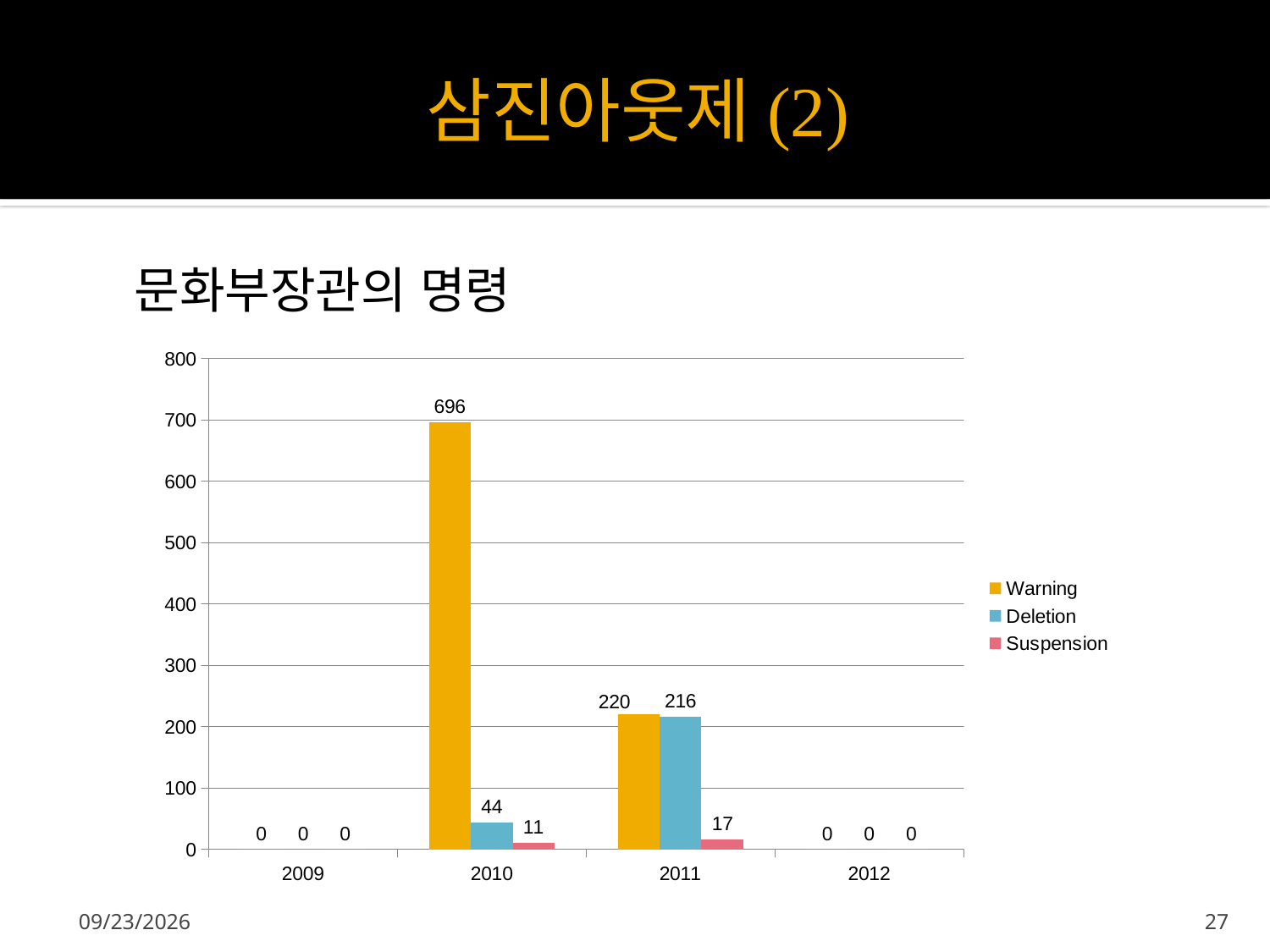
What is the total of Warning, Deletion and Suspension in 2011? 453 Which year has the highest Warning value? 2010 What is the difference between the Warning values for 2010 and 2011? 476 What is the value for Suspension in 2010? 11 Is the value for Warning in 2010 greater or less than 600? greater How many years are shown on the x axis? 4 Which is larger in 2011, Warning or Deletion? Warning Which series is shown in blue in the legend? Deletion How many series does the legend list? 3 What kind of chart is shown on the slide? bar chart What is the value for Warning in 2010? 696 What is the value for Deletion in 2011? 216